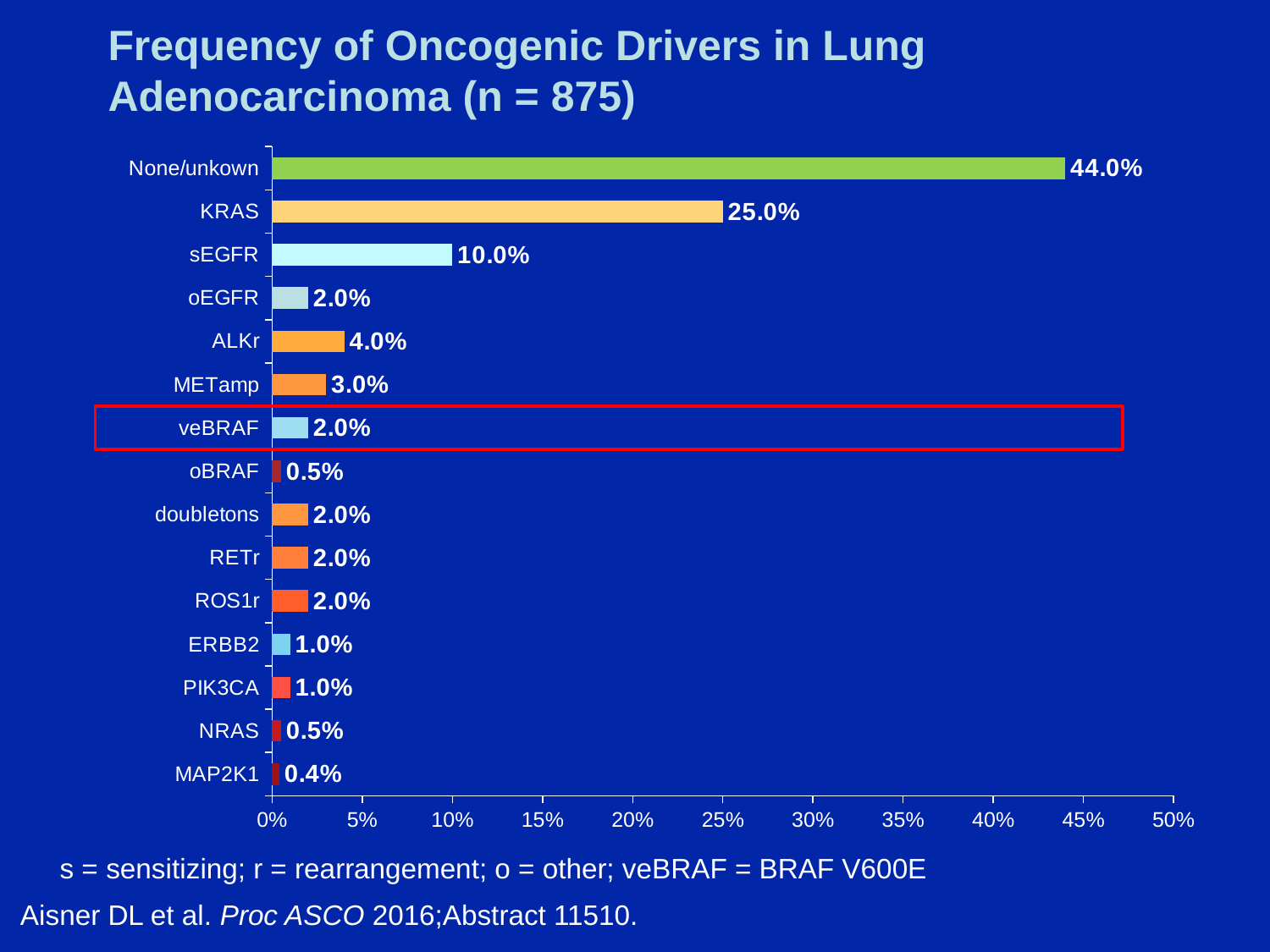
Is the value for None/unkown greater or less than 40%? greater Which category is highlighted with a red box? veBRAF What kind of chart is shown on the slide? bar chart What is the value for KRAS? 25.0% What is the difference between the values for KRAS and sEGFR? 15.0% What is the value for veBRAF? 2.0% What is the title of the chart? Frequency of Oncogenic Drivers in Lung Adenocarcinoma (n = 875) Which is larger, the value for ALKr or the value for METamp? ALKr Which category has the highest value? None/unkown What is the value for MAP2K1? 0.4% Which category has the lowest value? MAP2K1 How many categories are shown in the chart? 15